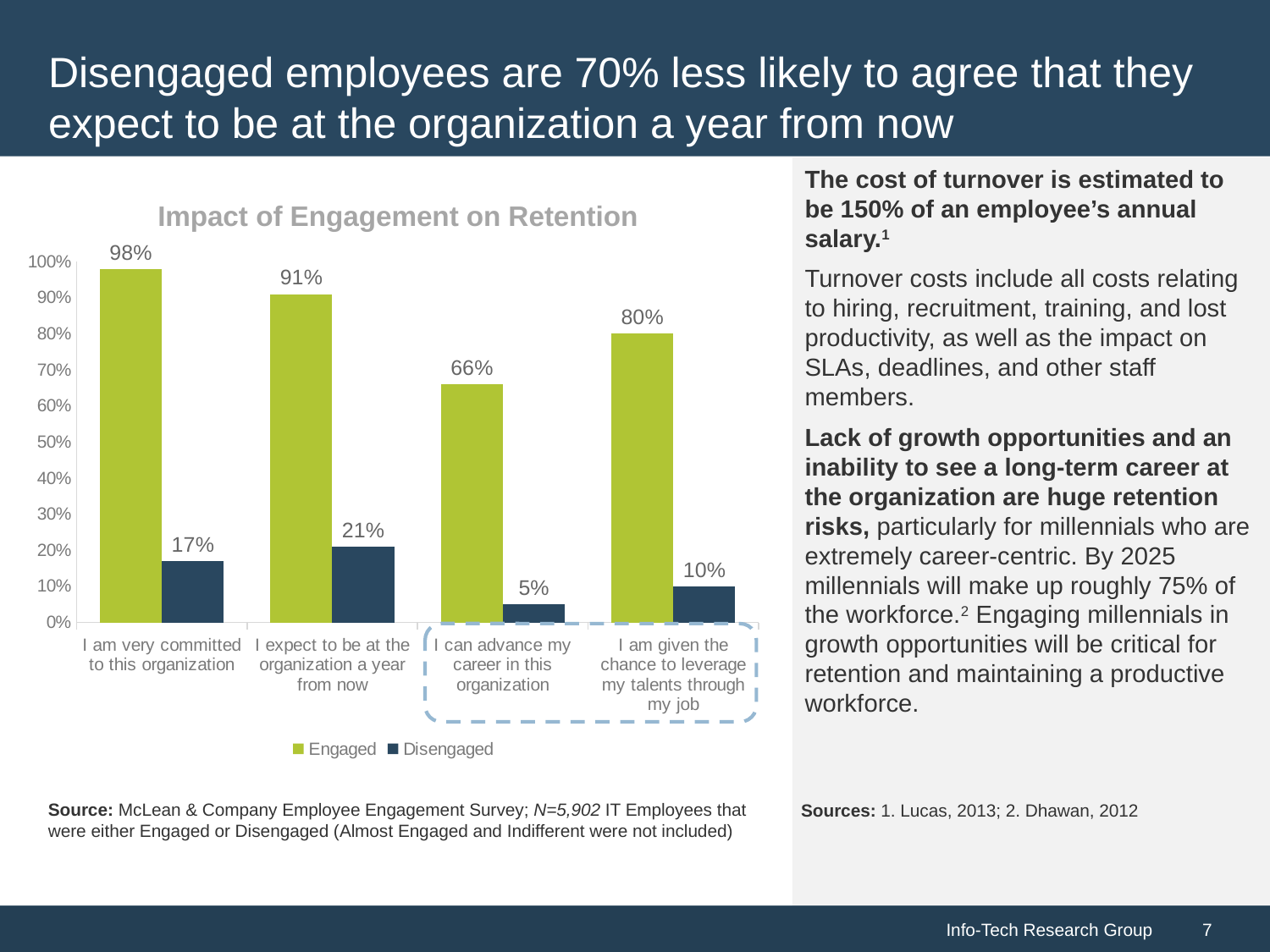
How many categories are shown on the x axis? 4 How many series does the legend list? 2 What kind of chart is shown? Bar chart What is the Engaged value for "I am very committed to this organization"? 98% Which is larger: the Engaged value for "I can advance my career in this organization" or the Engaged value for "I am given the chance to leverage my talents through my job"? I am given the chance to leverage my talents through my job What is the difference between the Engaged and Disengaged values for "I expect to be at the organization a year from now"? 70% What is the Disengaged value for "I can advance my career in this organization"? 5% What is the Disengaged value for "I expect to be at the organization a year from now"? 21% What is the title of the chart? Impact of Engagement on Retention Which category has the highest Engaged value? I am very committed to this organization Which category has the lowest Disengaged value? I can advance my career in this organization What is the difference between the Engaged and Disengaged values for "I am given the chance to leverage my talents through my job"? 70%